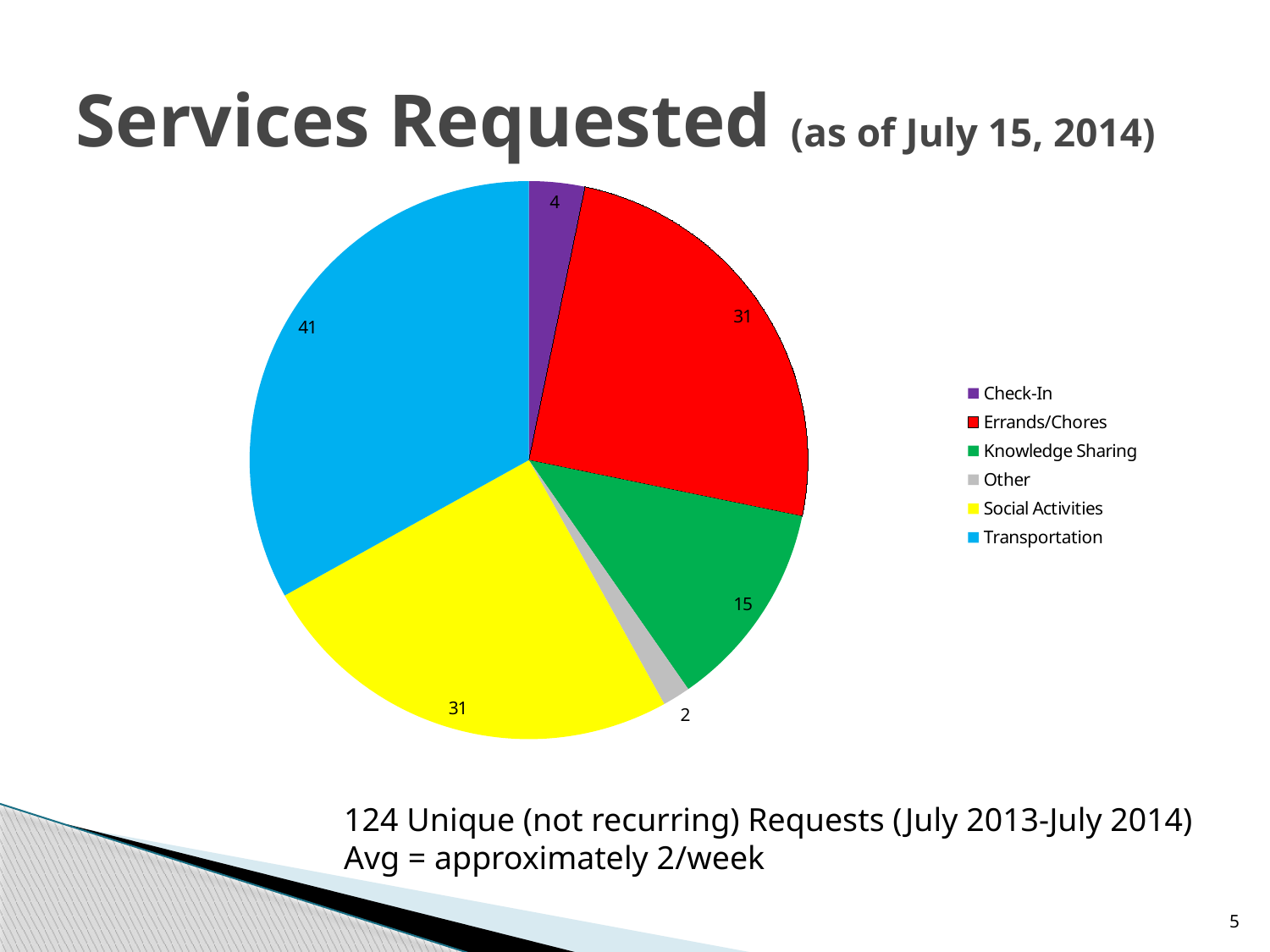
What is the difference between the Transportation value and the Knowledge Sharing value? 26 Which service category has the largest slice of the pie? Transportation What value is shown for the Check-In slice? 4 What value is shown for the Knowledge Sharing slice? 15 Which is larger, the Knowledge Sharing slice or the Check-In slice? Knowledge Sharing What value is shown for the Transportation slice? 41 What colour represents Social Activities in the pie chart? Yellow What type of chart is shown on the slide? Pie chart What is the difference between the Errands/Chores value and the Check-In value? 27 What value is shown for the Other slice? 2 Which service category has the smallest slice of the pie? Other How many service categories are shown in the pie chart? 6